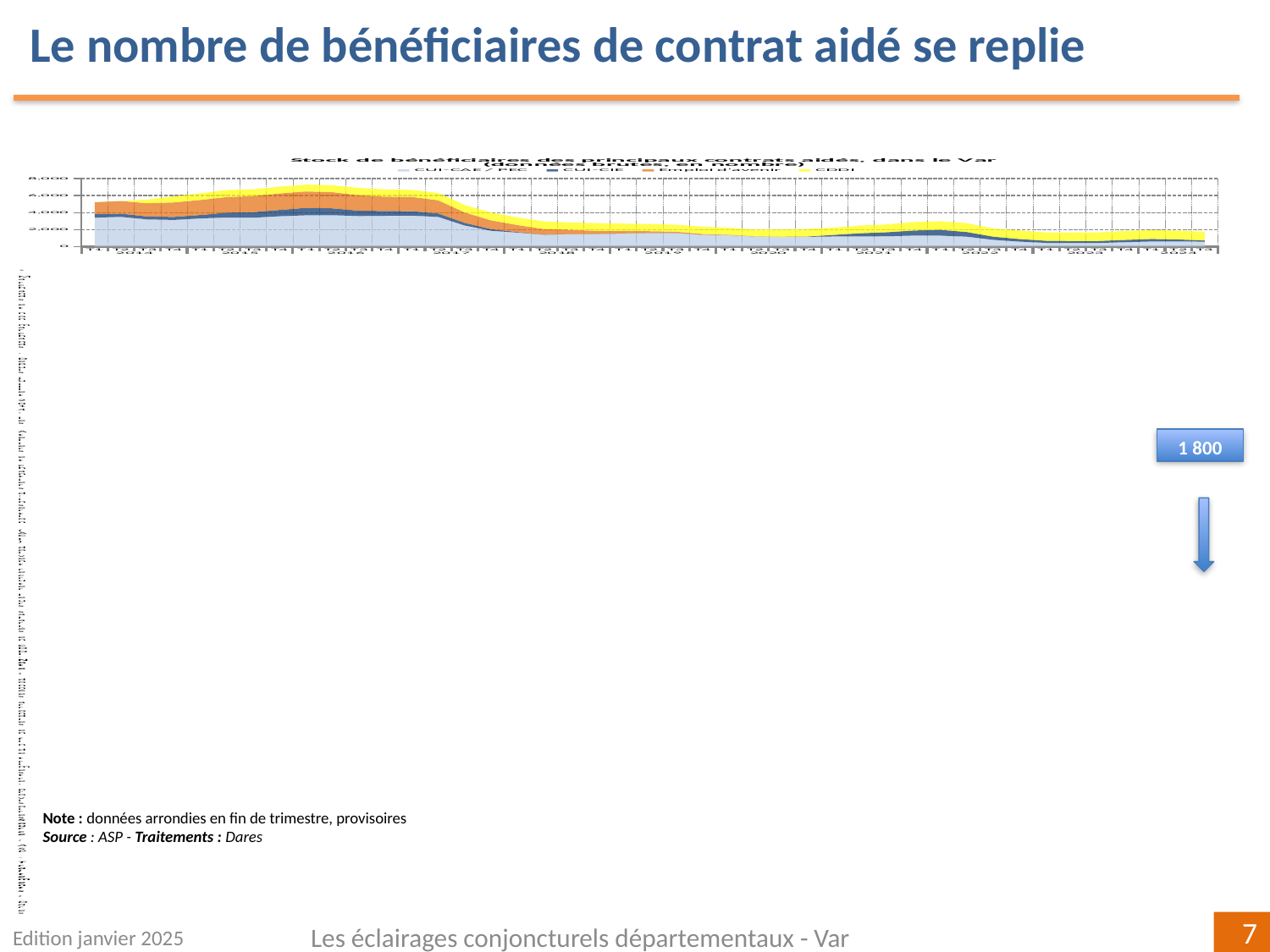
Is the total stacked value in 2024 greater or less than 2,000? less Which series in the chart is drawn in yellow? CDDI Is the total stacked value in 2014 greater or less than 4,000? greater Overall, do the stacked values in the chart rise or fall from 2014 to 2024? fall What kind of chart is shown on the slide? area chart How many series does the legend of the chart list? 4 Is the total stacked value in 2021 greater or less than 4,000? less Is the total stacked value higher in 2016 or in 2020? 2016 What is the highest tick value shown on the vertical axis of the chart? 8,000 What is the title of the chart? Stock de bénéficiaires des principaux contrats aidés, dans le Var (données brutes, en nombre)